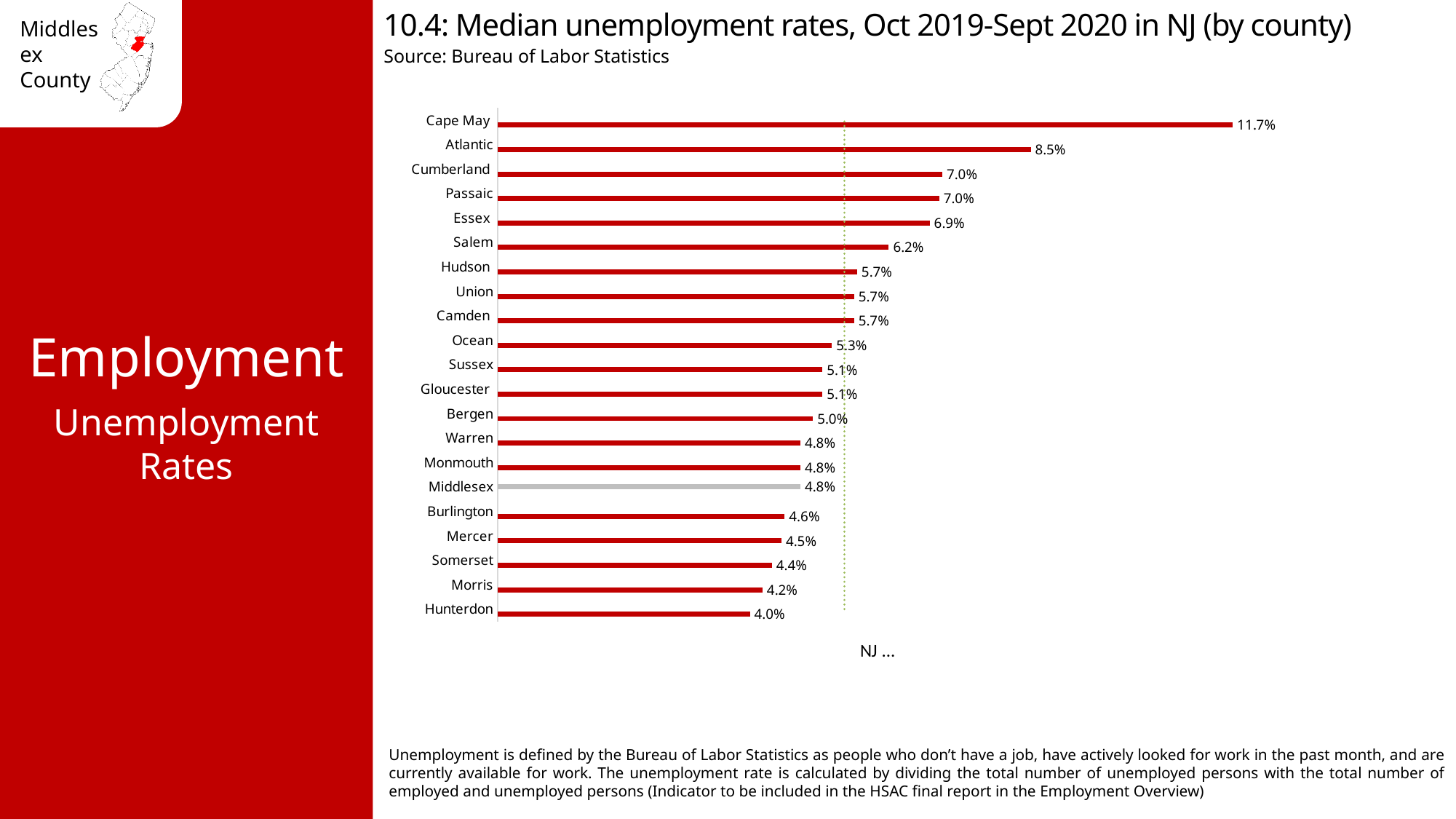
What is the source cited for the chart? Bureau of Labor Statistics How many counties are shown in the chart? 21 What is the median unemployment rate for Cape May? 11.7% Which county has a higher median unemployment rate, Salem or Ocean? Salem What is the median unemployment rate for Middlesex County? 4.8% What type of chart is used on this slide? Bar chart Which county's bar is shown in grey rather than red? Middlesex What is the difference between the median unemployment rates of Cape May and Atlantic? 3.2% Which county has the highest median unemployment rate? Cape May What is the median unemployment rate for Hunterdon? 4.0% Which county has the lowest median unemployment rate? Hunterdon What is the difference between the median unemployment rates of Middlesex and Hunterdon? 0.8%